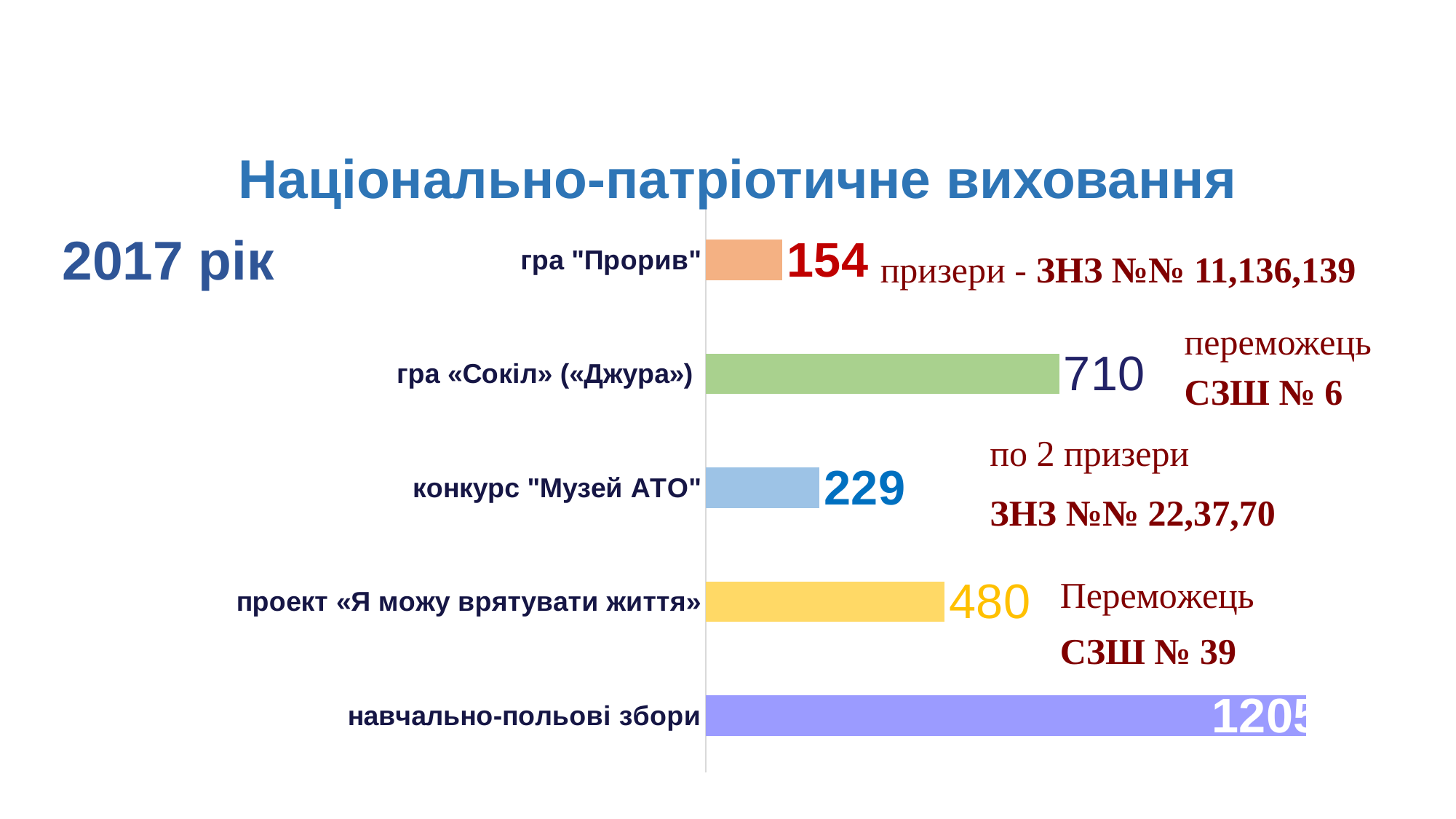
What value is shown for конкурс "Музей АТО"? 229 Which category has the highest value? навчально-польові збори What value is shown for проект «Я можу врятувати життя»? 480 What is the difference between the values for гра «Сокіл» («Джура») and проект «Я можу врятувати життя»? 230 What is the title of the slide containing the chart? Національно-патріотичне виховання Which category has the lowest value? гра "Прорив" Which is larger, the value for конкурс "Музей АТО" or the value for гра "Прорив"? конкурс "Музей АТО" What value is shown for гра "Прорив"? 154 What kind of chart is shown on the slide? bar chart What value is shown for навчально-польові збори? 1205 What value is shown for гра «Сокіл» («Джура»)? 710 How many categories are shown in the chart? 5